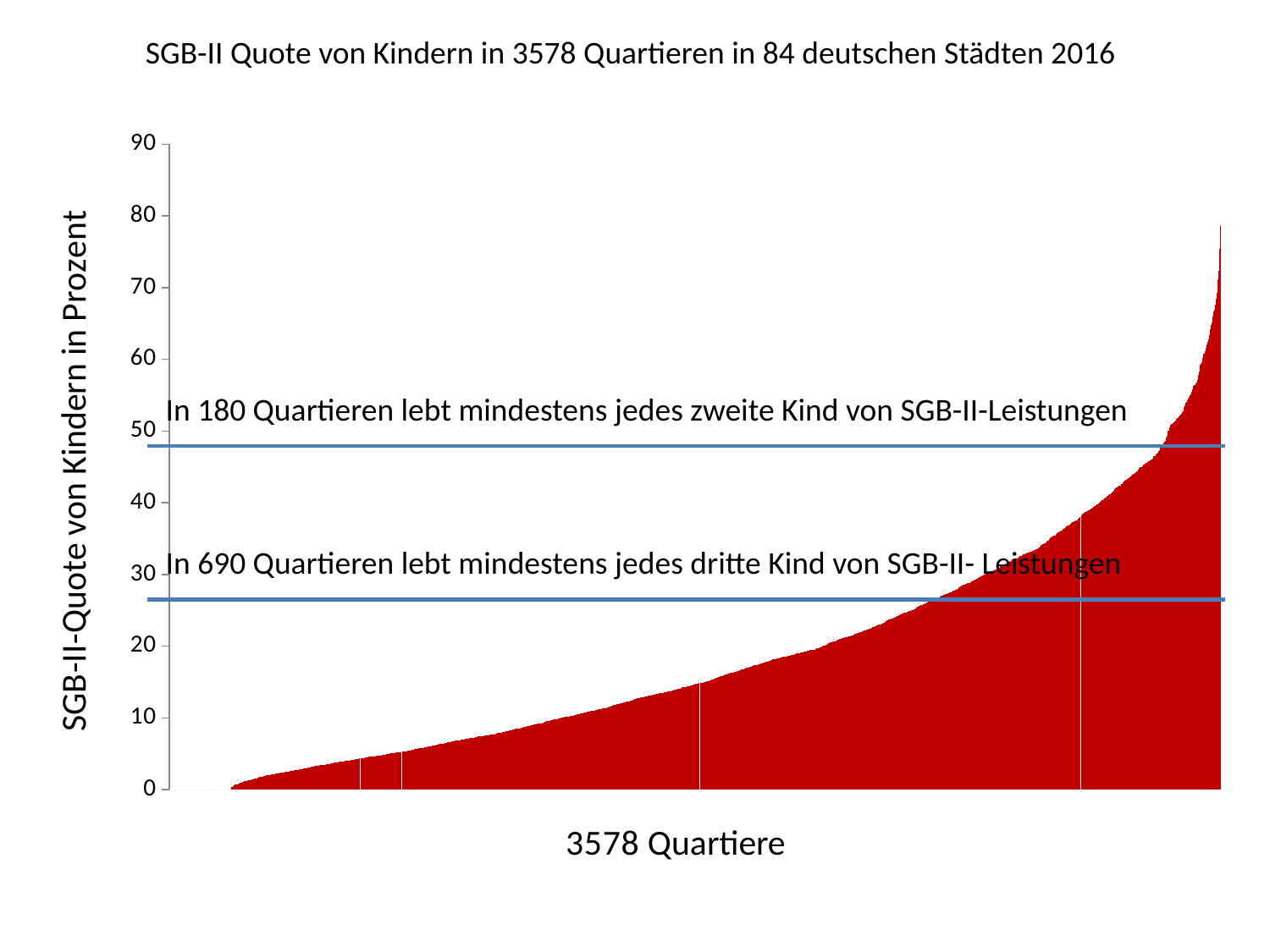
Do the values rise or fall from left to right along the x axis? rise According to the annotation, in how many Quartieren does at least every second child live on SGB-II benefits? 180 Is the highest value in the chart greater or less than 70? greater Which year does the chart's data refer to? 2016 How many Quartiere (neighbourhoods) are plotted in the chart? 3578 What kind of chart is shown on the slide? bar chart According to the annotation, in how many Quartieren does at least every third child live on SGB-II benefits? 690 What is the title of the chart? SGB-II Quote von Kindern in 3578 Quartieren in 84 deutschen Städten 2016 Is the highest value in the chart greater or less than 80? less What is the label of the y axis? SGB-II-Quote von Kindern in Prozent What is the highest tick value shown on the y axis? 90 How many horizontal blue reference lines are drawn across the chart? 2